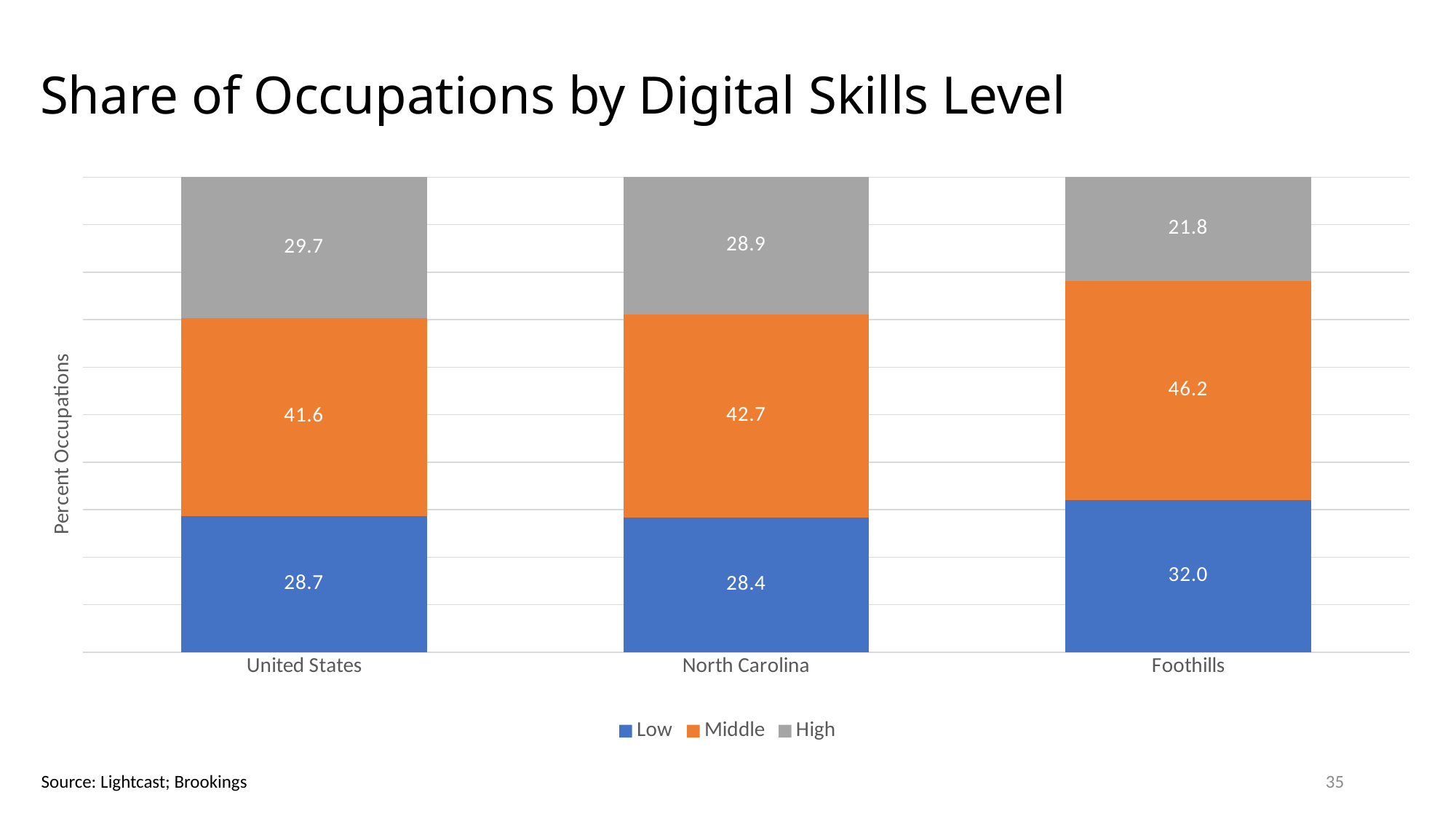
What is the Middle value for Foothills? 46.2 How many categories are shown on the x axis? 3 Which category has the highest Low value? Foothills How many series does the legend list? 3 What is the High value for United States? 29.7 What is the label on the vertical axis? Percent Occupations What is the total of the stacked bar for Foothills? 100.0 What is the Low value for North Carolina? 28.4 What kind of chart is shown on the slide? Stacked bar chart What is the difference between the Middle values for Foothills and United States? 4.6 Which category has the lowest High value? Foothills Which is larger, the High value for United States or the High value for North Carolina? United States